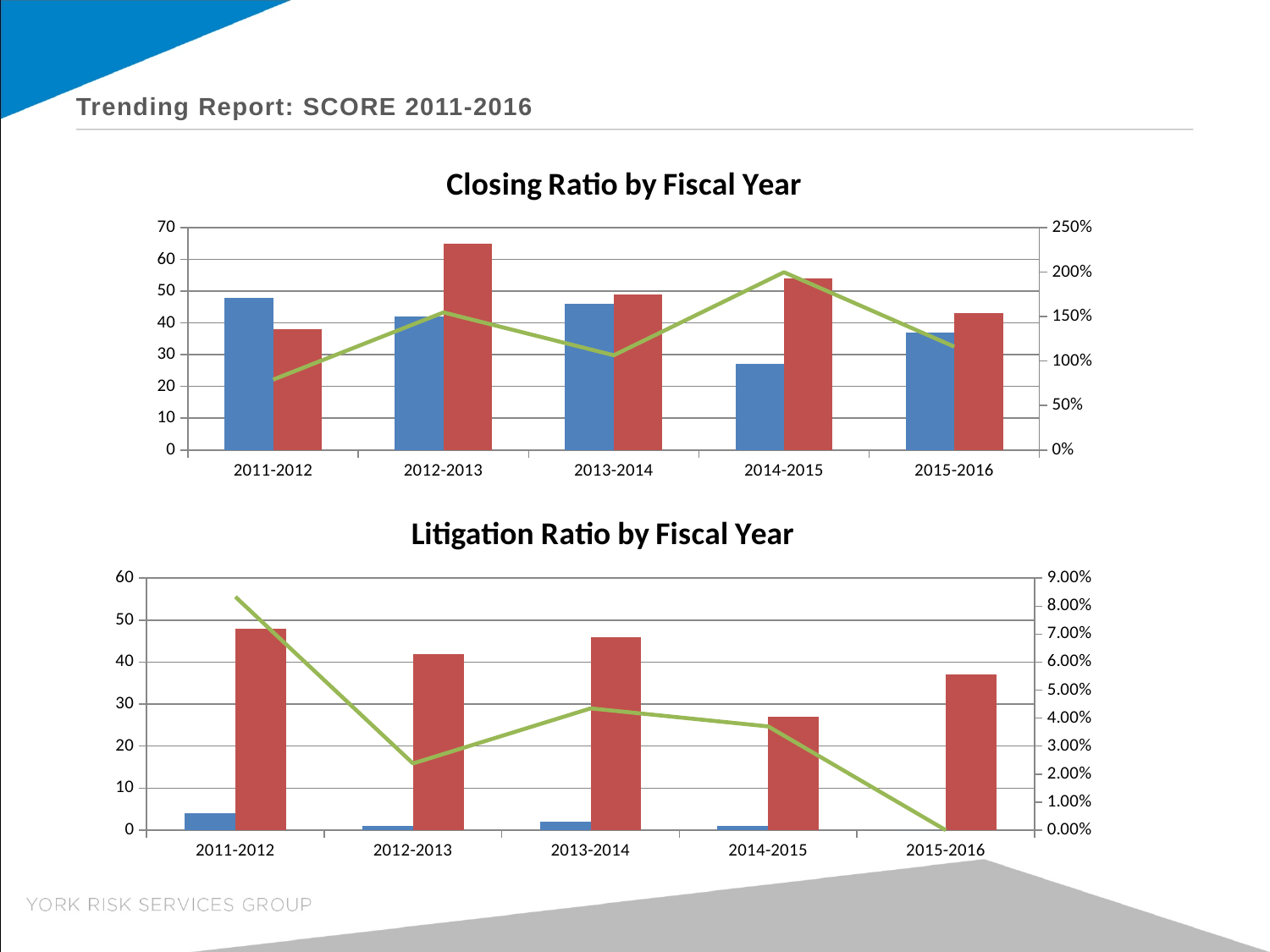
In the "Closing Ratio by Fiscal Year" chart, for 2011-2012, which bar is taller, the blue bar or the red bar? The blue bar In the "Closing Ratio by Fiscal Year" chart, in which fiscal year does the green line reach its highest point? 2014-2015 In the "Litigation Ratio by Fiscal Year" chart, which fiscal year has the tallest red bar? 2011-2012 In the "Litigation Ratio by Fiscal Year" chart, in which fiscal year is the green line at its lowest point? 2015-2016 How many fiscal years are shown on the x axis of the "Closing Ratio by Fiscal Year" chart? 5 In the "Litigation Ratio by Fiscal Year" chart, does the green line rise or fall from 2014-2015 to 2015-2016? It falls In the "Closing Ratio by Fiscal Year" chart, which fiscal year has the tallest red bar? 2012-2013 In the "Litigation Ratio by Fiscal Year" chart, is the green line value for 2011-2012 greater or less than 8.00%? greater What kind of chart is the "Closing Ratio by Fiscal Year" chart? A combined bar and line chart In the "Closing Ratio by Fiscal Year" chart, which fiscal year has the shortest blue bar? 2014-2015 In the "Closing Ratio by Fiscal Year" chart, is the red bar for 2012-2013 greater or less than 60? greater In the "Closing Ratio by Fiscal Year" chart, is the blue bar for 2014-2015 greater or less than 30? less